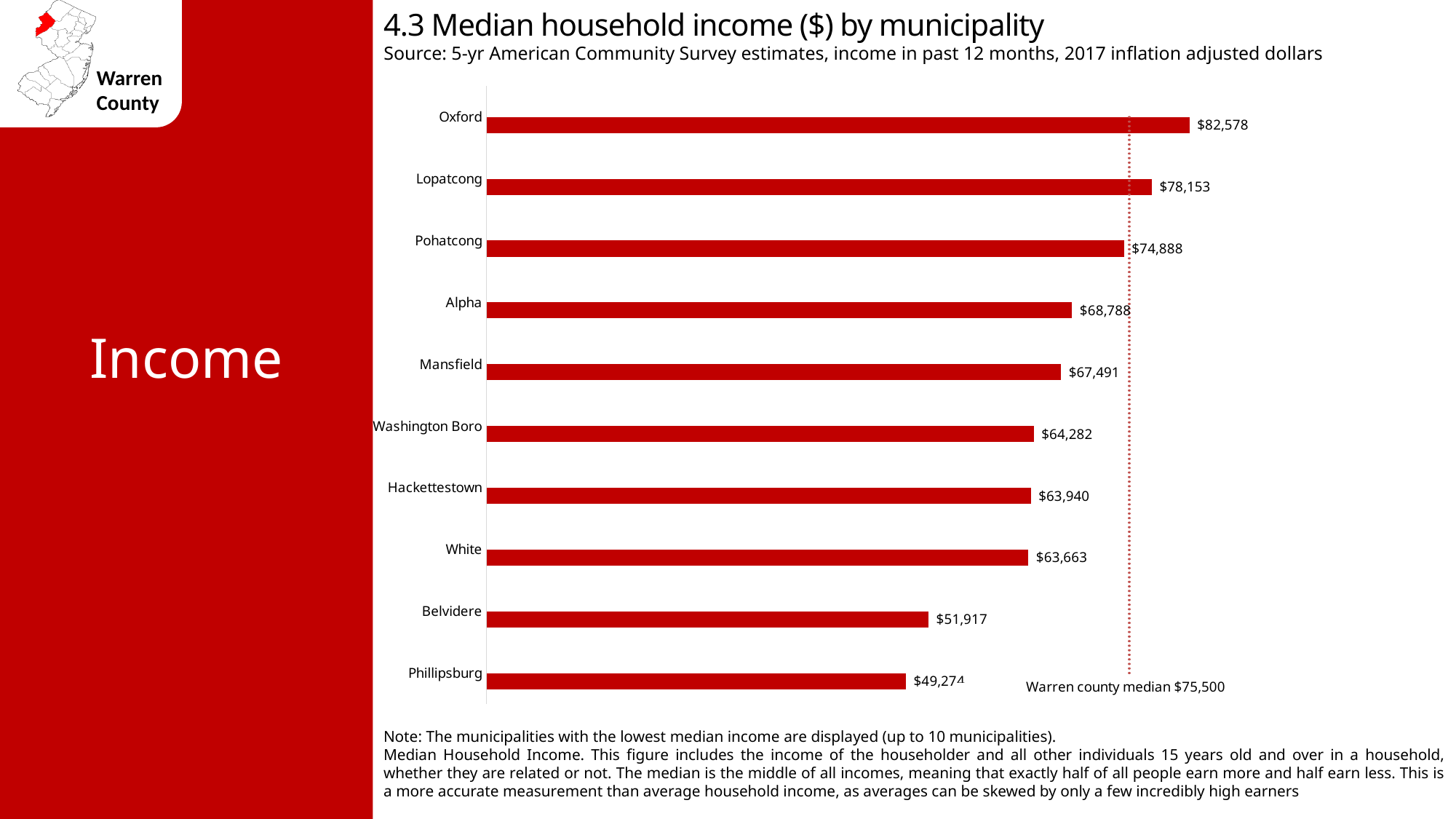
What is the difference between the median household income of Lopatcong and Pohatcong? $3,265 What is the median household income for Oxford? $82,578 Which municipality has the highest median household income on the chart? Oxford What value does the dotted reference line on the chart represent? Warren county median $75,500 What is the median household income for Hackettestown? $63,940 Which has a higher median household income, Belvidere or Washington Boro? Washington Boro What is the median household income for Belvidere? $51,917 What is the difference between the median household income of Oxford and Phillipsburg? $33,304 How many municipalities are shown on the chart? 10 Which has a higher median household income, Alpha or Mansfield? Alpha Which municipality has the lowest median household income on the chart? Phillipsburg What kind of chart is used to show median household income by municipality? Bar chart